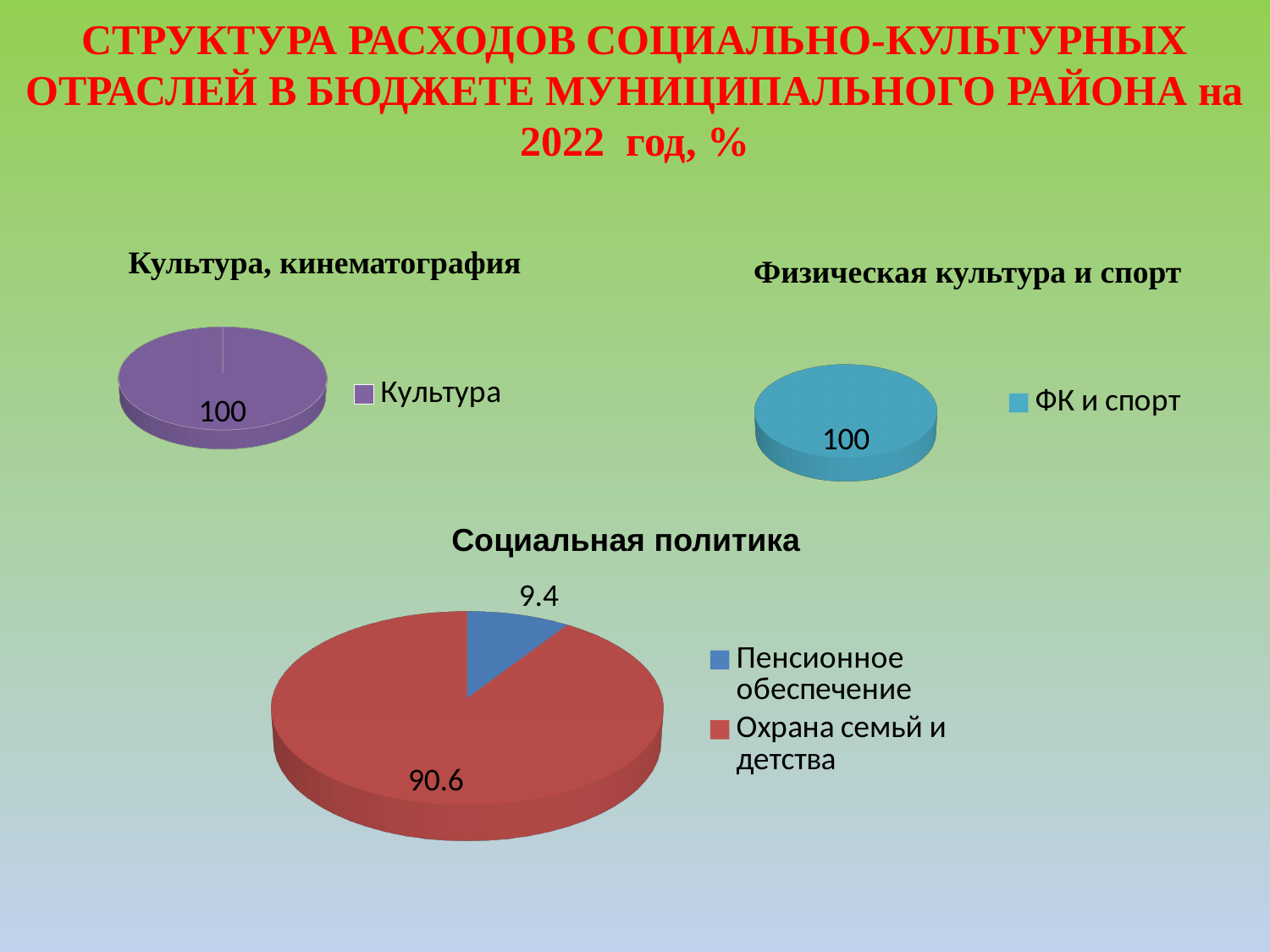
In the 'Культура, кинематография' chart, what is the value for 'Культура'? 100 In the 'Физическая культура и спорт' chart, what is the value for 'ФК и спорт'? 100 How many legend entries does the 'Социальная политика' chart list? 2 In the 'Социальная политика' chart, which category has the smallest slice? Пенсионное обеспечение In the 'Социальная политика' chart, what colour is the 'Пенсионное обеспечение' slice? Blue What kind of chart is the 'Социальная политика' chart? Pie chart In the 'Социальная политика' chart, what is the value for 'Пенсионное обеспечение'? 9.4 In the 'Социальная политика' chart, what is the difference between the values for 'Охрана семьи и детства' and 'Пенсионное обеспечение'? 81.2 In the 'Социальная политика' chart, how many slices does the pie have? 2 In the 'Социальная политика' chart, which category has the largest slice? Охрана семьй и детства How many charts are shown on the slide? 3 In the 'Социальная политика' chart, what is the value for 'Охрана семьи и детства'? 90.6